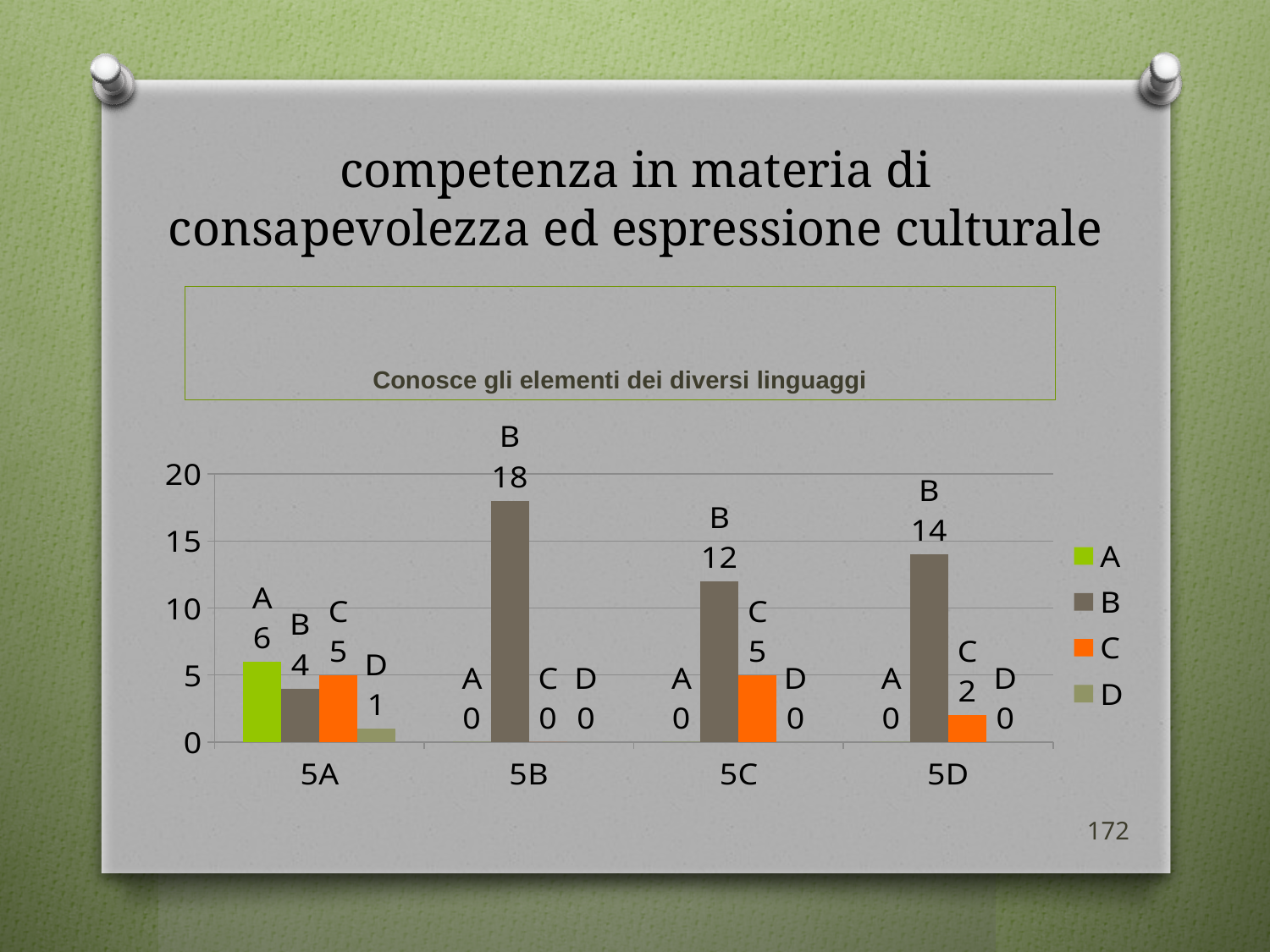
What is the difference between the B values for 5B and 5C? 6 What is the value of series A for category 5A? 6 What is the value of series C for category 5D? 2 What is the text in the box above the chart? Conosce gli elementi dei diversi linguaggi Which category has the lowest value for series B? 5A Is the B value for 5D greater or less than 10? greater Which category has the highest value for series B? 5B How many series does the legend list? 4 What kind of chart is shown on the slide? bar chart What is the value of series B for category 5B? 18 How many categories are shown on the x axis? 4 Which is larger: the C value for 5A or the C value for 5D? 5A